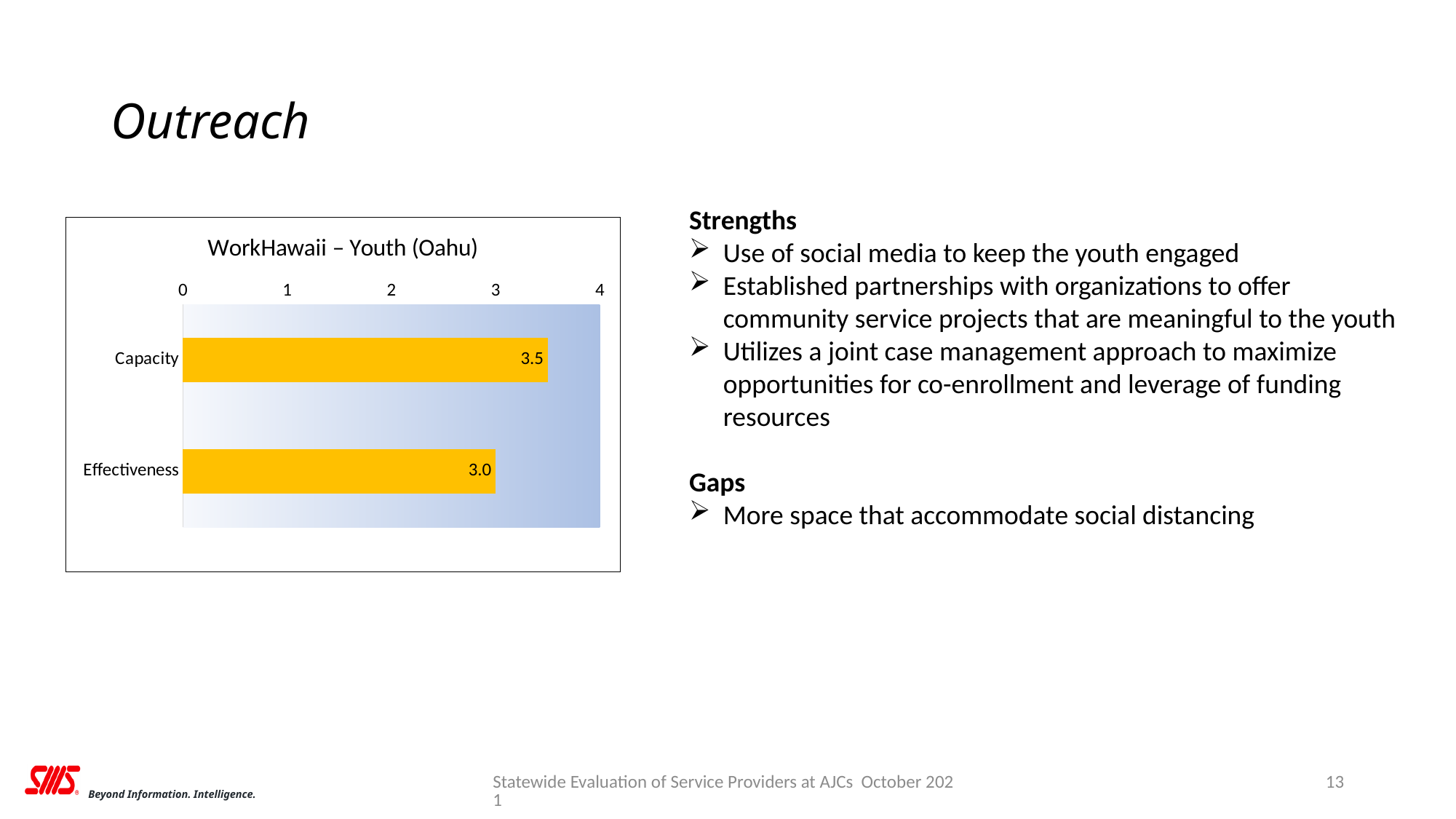
Which is larger, the value for Capacity or the value for Effectiveness? Capacity What is the maximum value shown on the chart's axis? 4 Which category has the highest value in the chart? Capacity Is the value for Capacity greater or less than 3? greater What kind of chart is shown on the slide? Bar chart What is the value for Capacity in the WorkHawaii – Youth (Oahu) chart? 3.5 What is the difference between the Capacity and Effectiveness values? 0.5 What is the title of the chart? WorkHawaii – Youth (Oahu) What is the value for Effectiveness in the WorkHawaii – Youth (Oahu) chart? 3.0 How many categories are shown in the chart? 2 Which category has the lowest value in the chart? Effectiveness Is the value for Effectiveness greater or less than 4? less